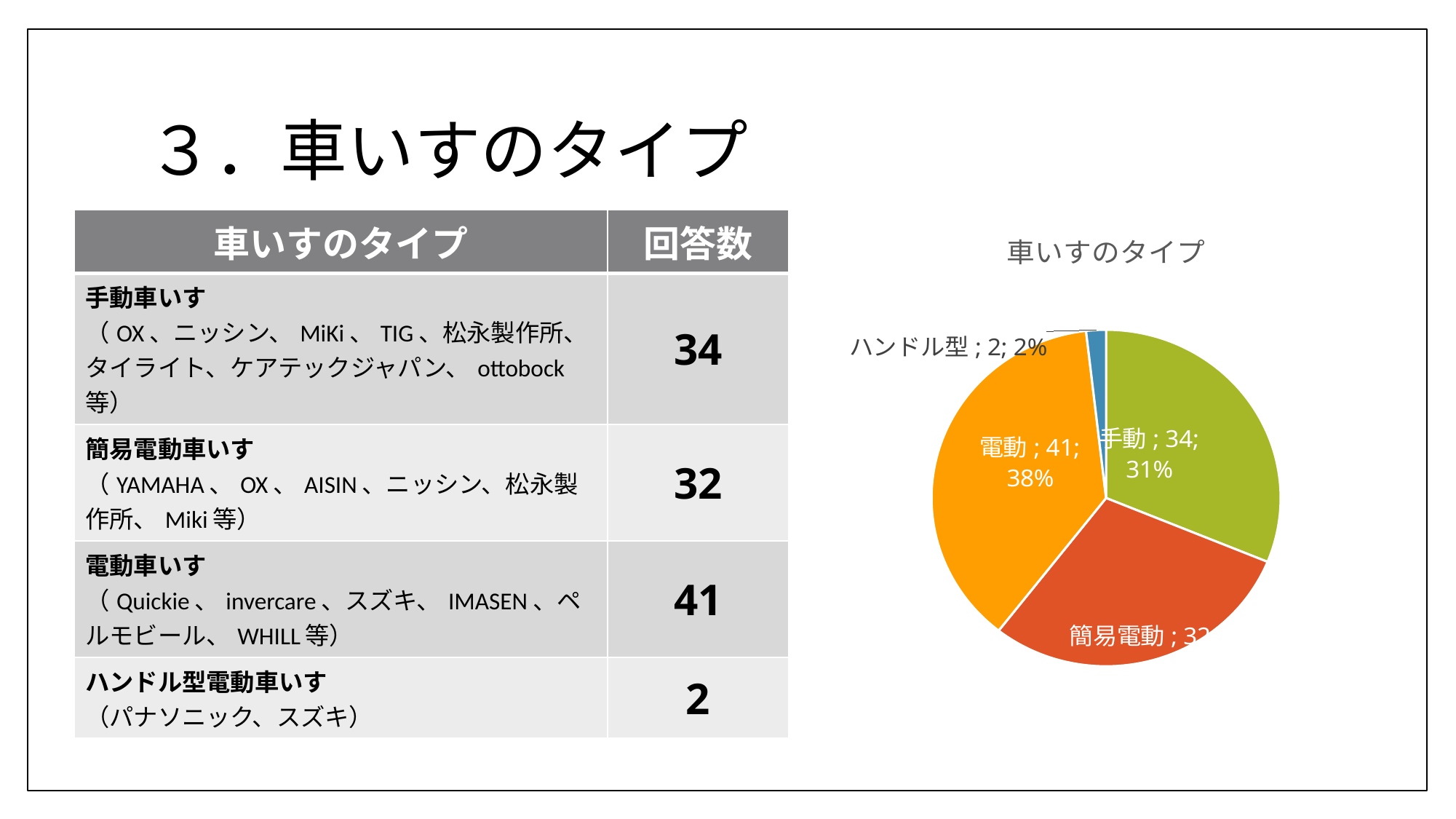
What is the title of the pie chart? 車いすのタイプ Which category has the smallest slice in the pie chart? ハンドル型 What is the value for ハンドル型 in the pie chart? 2 Which is larger in the pie chart, 電動 or 簡易電動? 電動 How many slices does the pie chart have? 4 What is the difference between the values for 電動 and 手動 in the pie chart? 7 What percentage share does the 電動 slice have in the pie chart? 38% What kind of chart is shown on the slide? pie chart What is the value for 手動 in the pie chart? 34 What percentage share does the 手動 slice have in the pie chart? 31% Which category has the largest slice in the pie chart? 電動 What is the value for 電動 in the pie chart? 41